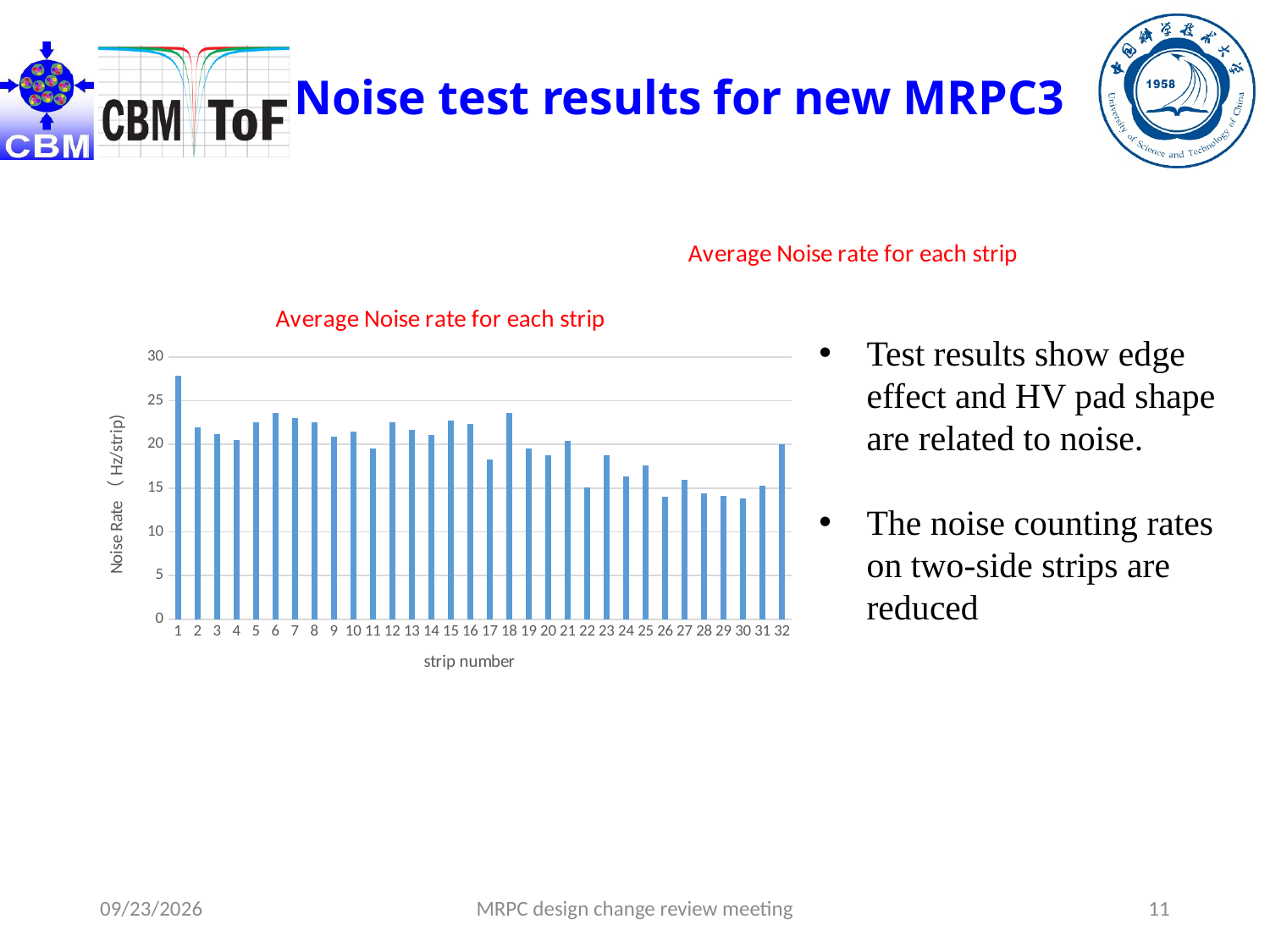
Which strip number has the highest average noise rate? 1 How many strips are plotted on the x axis of the chart? 32 What kind of chart is shown on the slide? bar chart Is the value for strip 22 greater or less than 20? less Is the value for strip 32 greater or less than 15? greater Is the value for strip 6 greater or less than 20? greater What is the title of the chart? Average Noise rate for each strip Which has a higher average noise rate, strip 1 or strip 30? strip 1 What is the label of the vertical axis of the chart? Noise Rate (Hz/strip) Do the noise rate values generally rise or fall from strip 1 to strip 32? fall